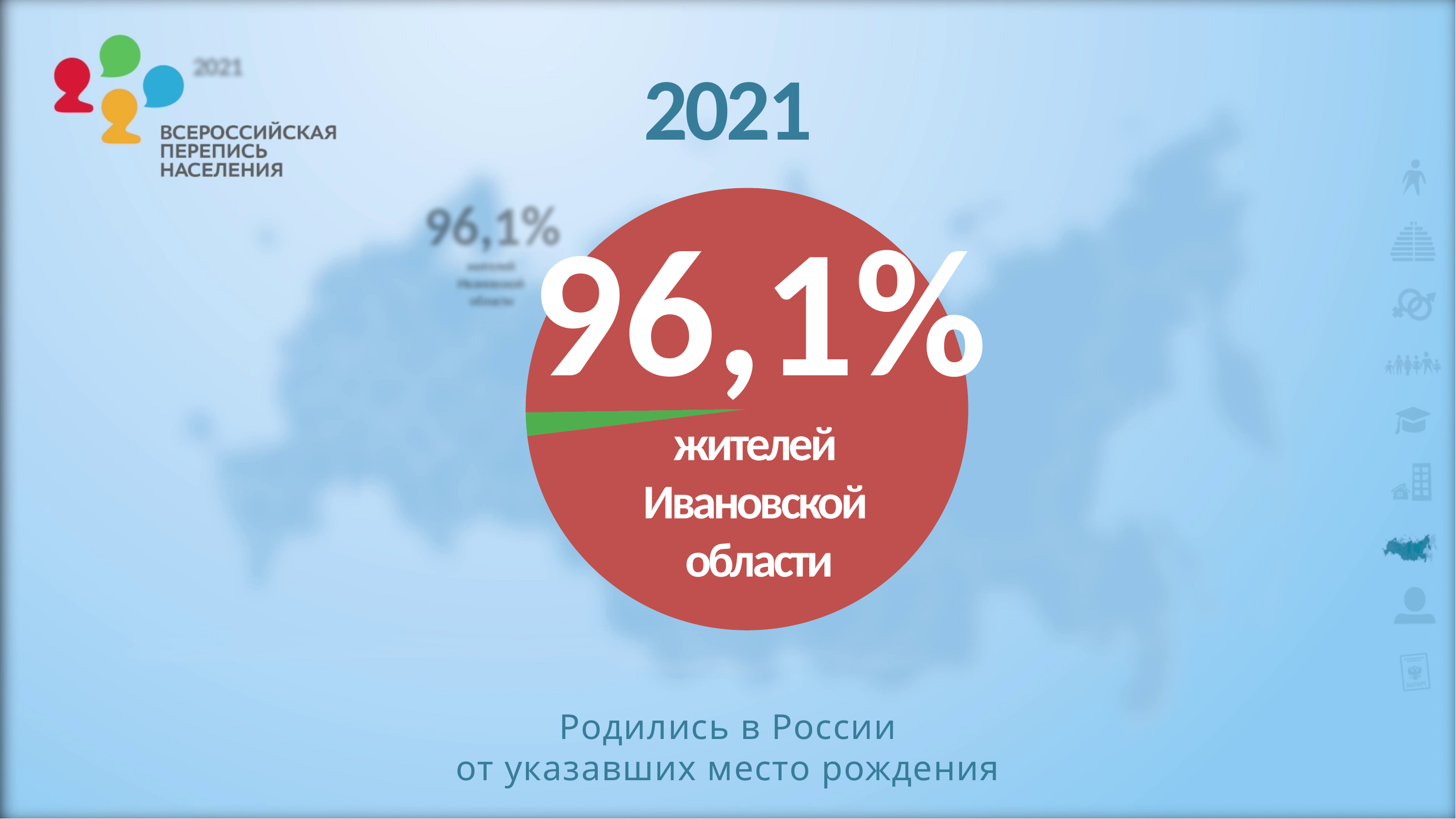
What share of the pie does the slice labelled "жителей Ивановской области" take? 96,1% Which slice of the pie is the largest? the red slice (96,1%) What does the caption below the chart say the data represents? Родились в России от указавших место рождения What year is shown as the title above the pie chart? 2021 What kind of chart is shown on the slide? pie chart Which slice is larger, the red one or the green one? the red one How many slices does the pie chart have? 2 What percentage of residents of Ivanovo Oblast does the large red slice represent? 96,1% Which slice of the pie is the smallest? the green slice